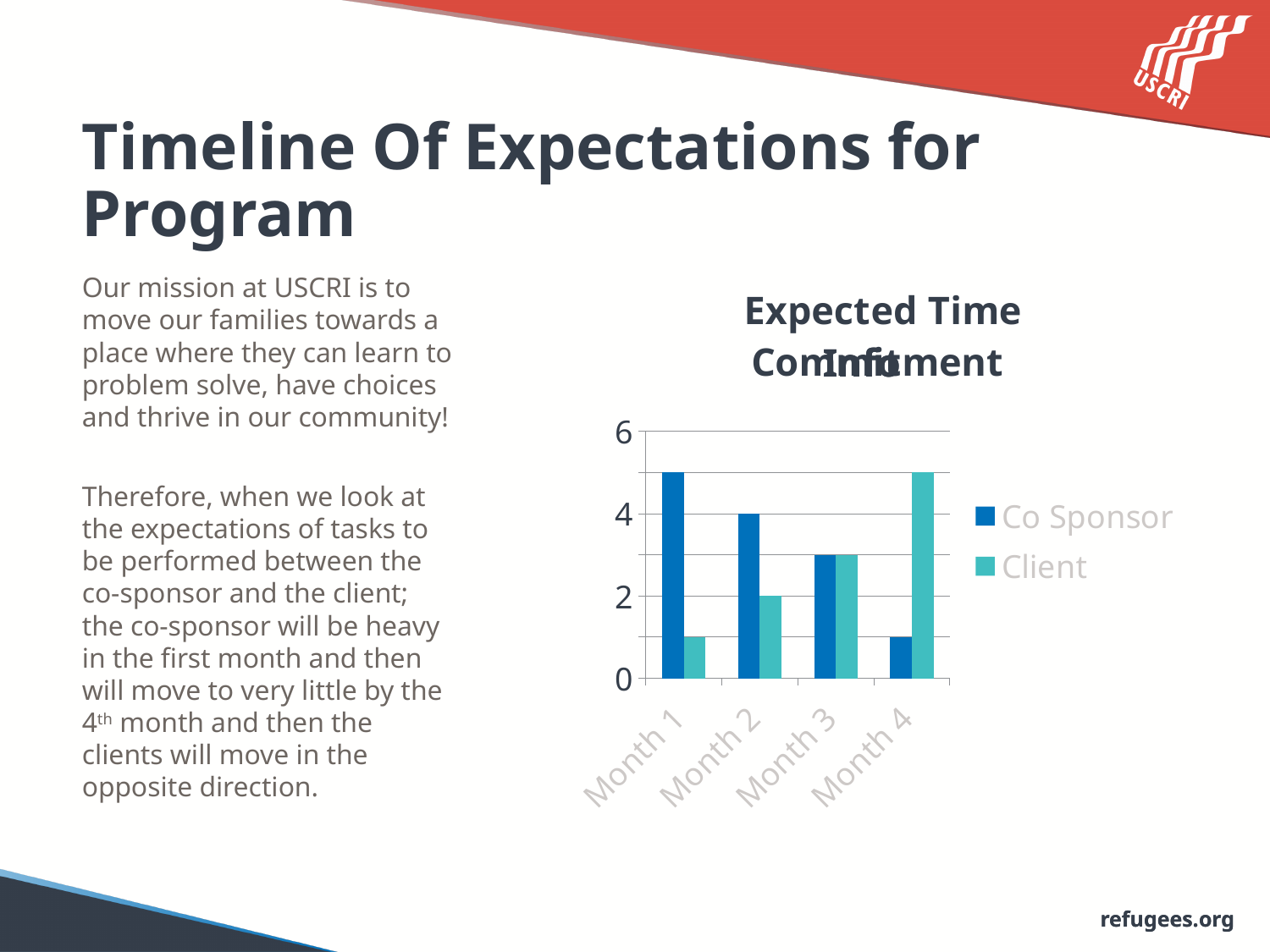
Do the Co Sponsor values rise or fall from Month 1 to Month 4? fall What is the Client value for Month 2? 2 What is the difference between the Co Sponsor and Client values for Month 2? 2 What kind of chart is shown on the slide? bar chart Is the Client value for Month 4 greater or less than 4? greater In which month is the Client value lowest? Month 1 Is the Co Sponsor value for Month 1 greater or less than 4? greater How many months are shown on the x axis of the chart? 4 In which month is the Co Sponsor value highest? Month 1 What is the Co Sponsor value for Month 2? 4 How many series does the chart's legend list? 2 Is the Client value for Month 1 greater or less than 2? less